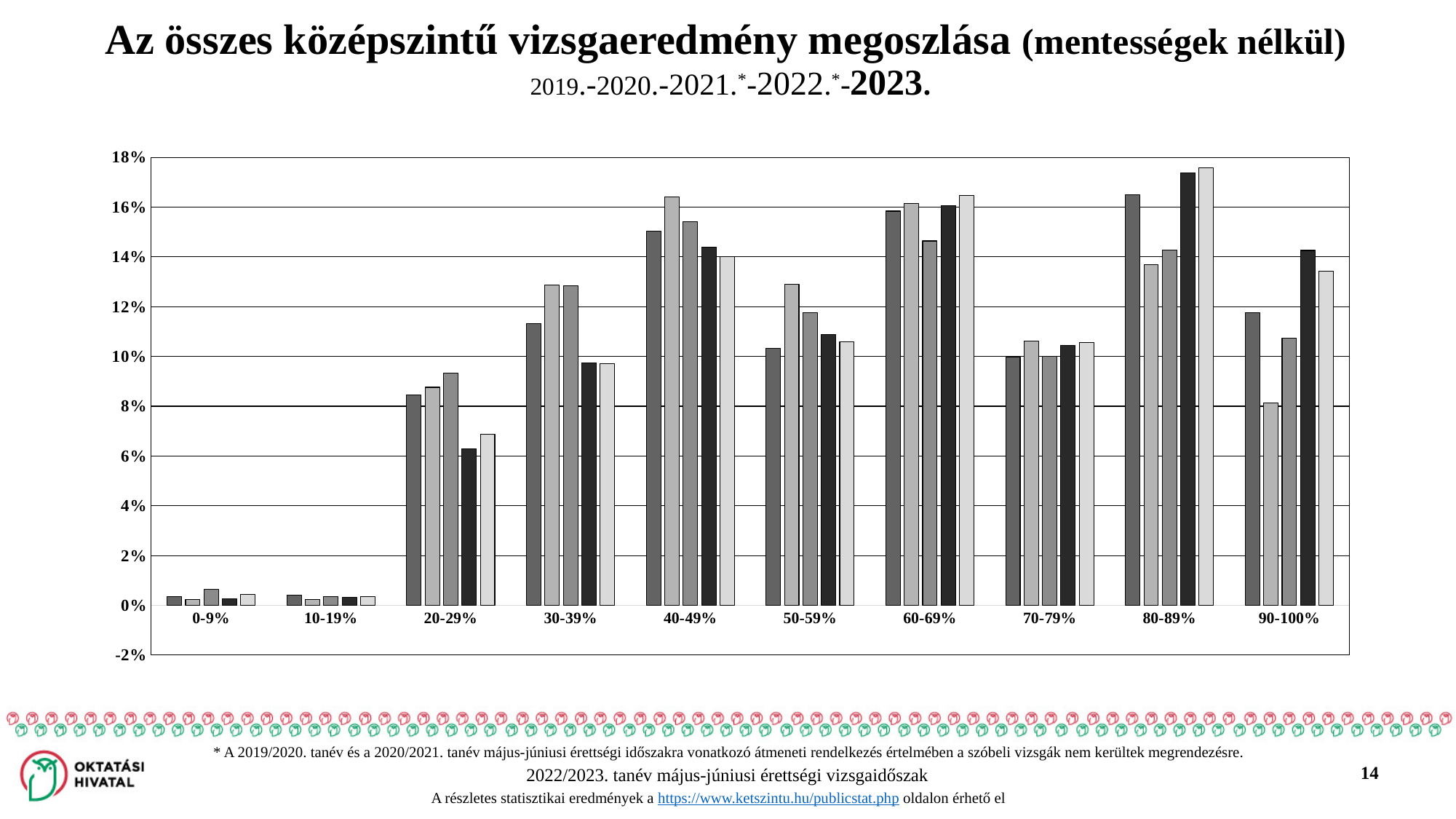
Is the value of the fourth (darkest) bar in the 80-89% group greater or less than 16%? greater What kind of chart is shown on the slide? bar chart Is the value of the first (leftmost) bar in the 20-29% group greater or less than 8%? greater What is the highest value labelled on the y axis? 18% Which is larger: the first (leftmost) bar in the 20-29% group or the first (leftmost) bar in the 30-39% group? 30-39% How many score-range categories are shown on the x axis? 10 Which is larger: the last (rightmost) bar in the 80-89% group or the last (rightmost) bar in the 90-100% group? 80-89% Is the value of the second bar in the 40-49% group greater or less than 16%? greater Which score-range category contains the tallest bar in the chart? 80-89% How many bars are plotted for each score-range category? 5